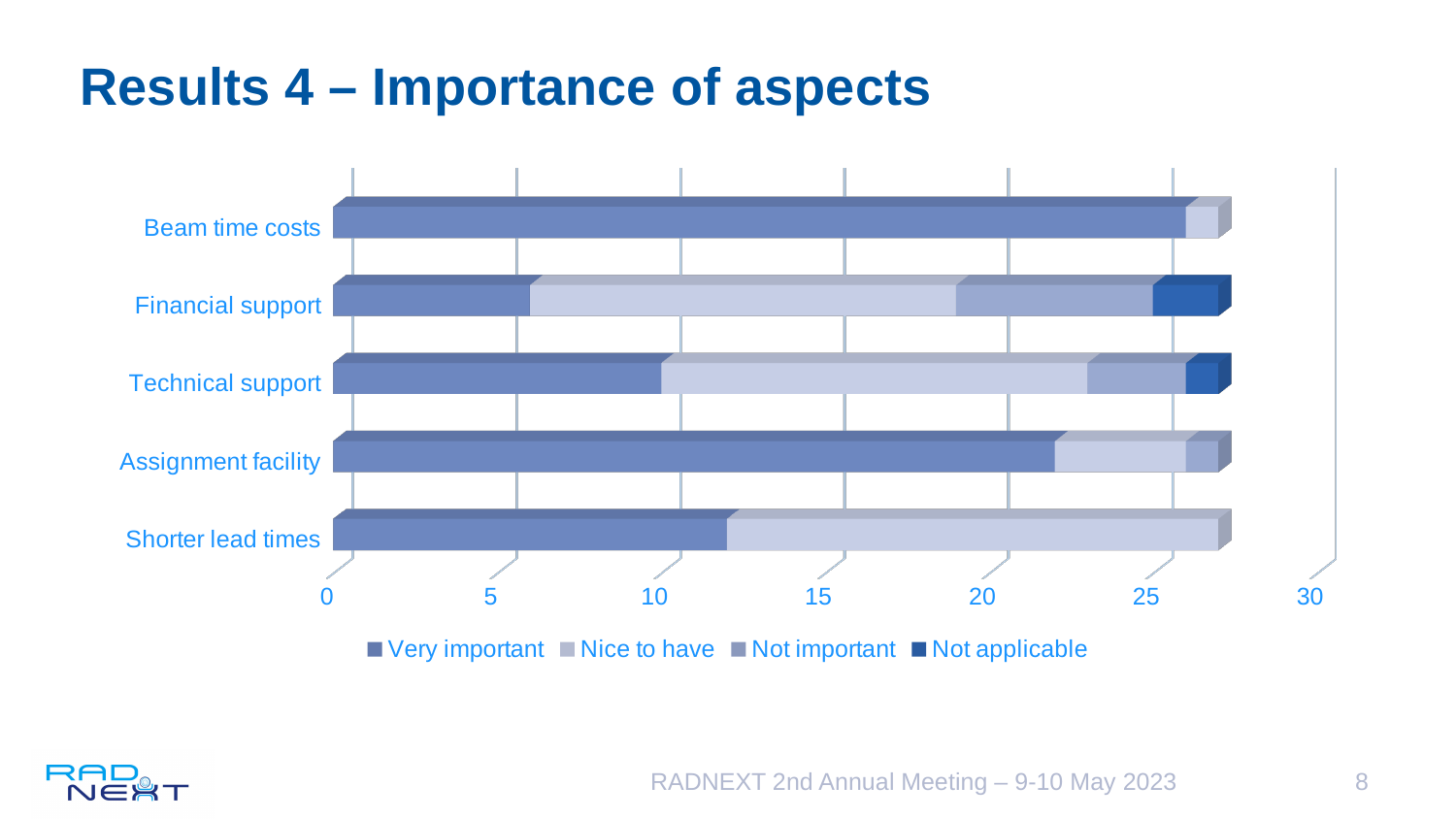
Which aspect has the largest 'Very important' segment? Beam time costs Which has the larger 'Very important' segment, Financial support or Technical support? Technical support How many categories (aspects) are plotted on the chart? 5 Is the 'Very important' value for Beam time costs greater or less than 20? greater Which aspect has the smallest 'Very important' segment? Financial support Is the 'Very important' value for Financial support greater or less than 10? less Is the 'Very important' value for Shorter lead times greater or less than 10? greater How many series does the legend list? 4 What is the title of the slide containing the chart? Results 4 – Importance of aspects Which has the larger 'Very important' segment, Assignment facility or Shorter lead times? Assignment facility What kind of chart is shown on the slide? bar chart